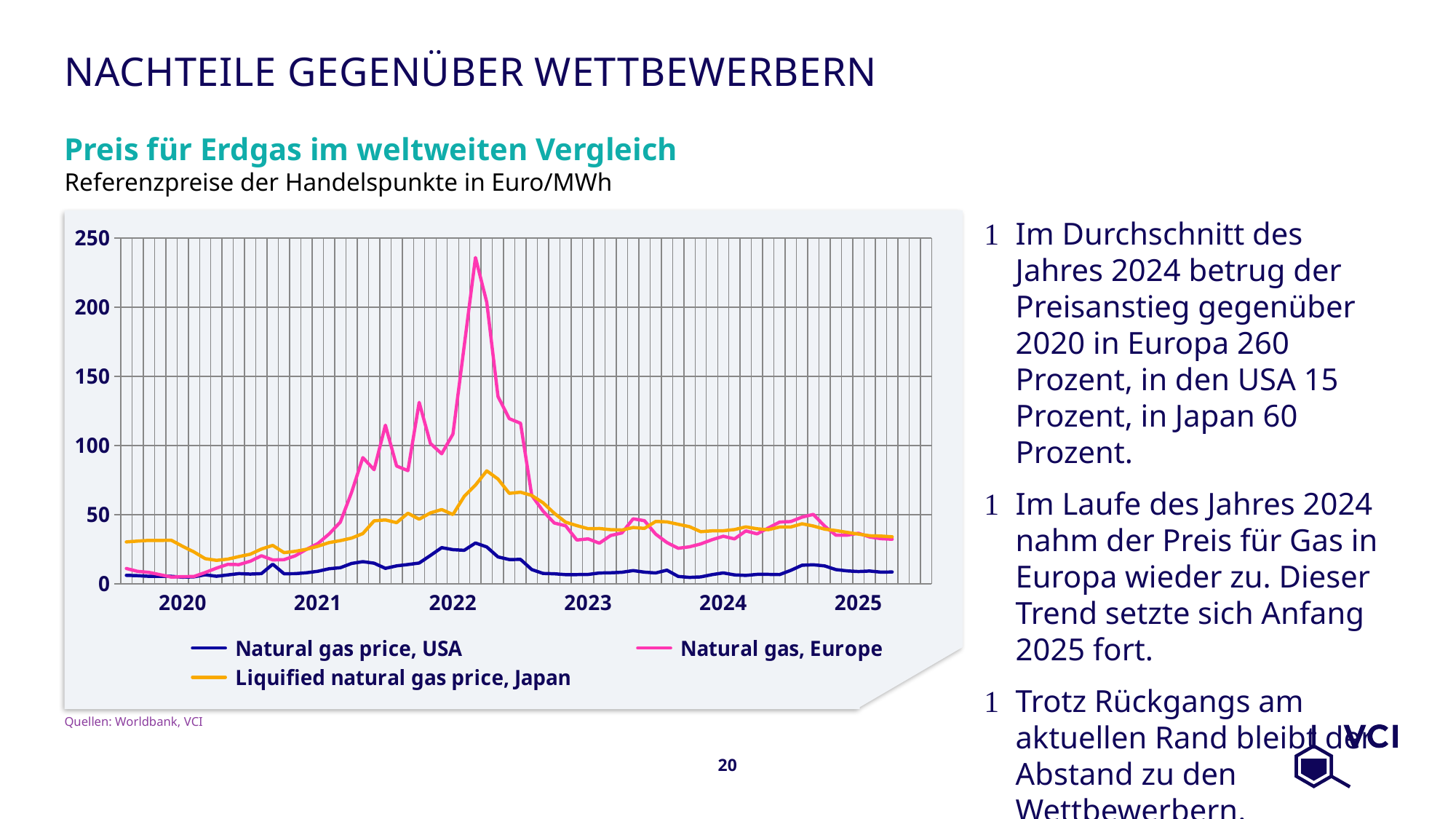
What is the title of the chart? Preis für Erdgas im weltweiten Vergleich Which series is shown in pink in the chart? Natural gas, Europe How many series does the legend of the chart list? 3 Is the value of the Natural gas price, USA series at any point greater or less than 50? less Does the Natural gas, Europe series rise or fall between its 2022 peak and 2023? fall What kind of chart is shown on the slide? line chart Which series reaches the highest value in the chart? Natural gas, Europe Is the peak value of the Liquified natural gas price, Japan series greater or less than 100? less At the 2022 peak, which series is higher: Natural gas, Europe or Liquified natural gas price, Japan? Natural gas, Europe Is the peak value of the Natural gas, Europe series greater or less than 200? greater What is the first year label shown on the x axis of the chart? 2020